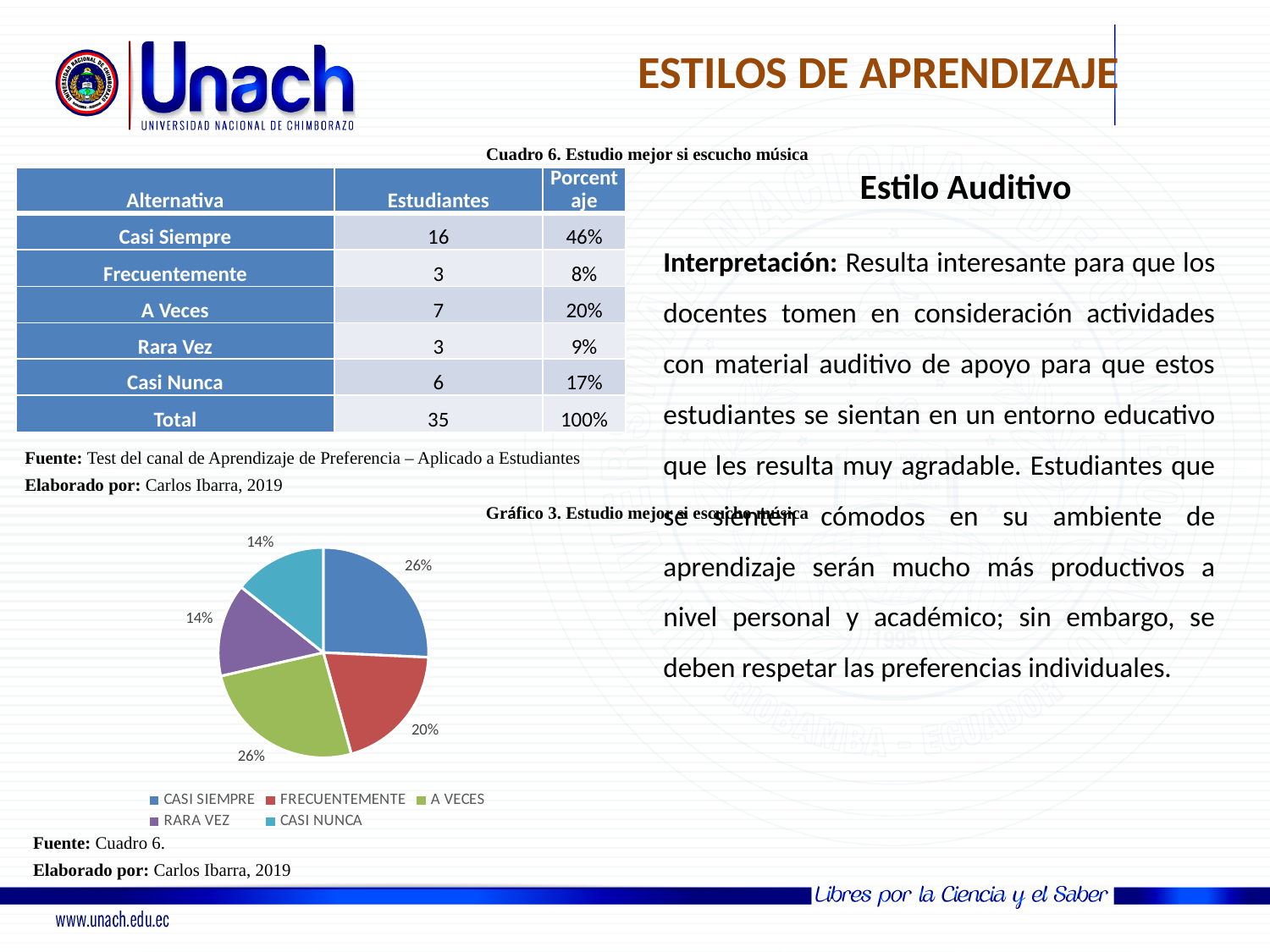
What kind of chart is shown on the slide? pie chart In the pie chart, what percentage is shown for RARA VEZ? 14% In the pie chart, what is the difference in percentage points between CASI SIEMPRE and RARA VEZ? 12 How many entries does the pie chart's legend list? 5 In the pie chart, what percentage is shown for CASI NUNCA? 14% In the pie chart, what percentage is shown for FRECUENTEMENTE? 20% What colour is the CASI SIEMPRE slice in the pie chart? blue In the pie chart, which is larger: CASI SIEMPRE or FRECUENTEMENTE? CASI SIEMPRE In the pie chart, what percentage is shown for A VECES? 26% How many slices does the pie chart have? 5 In the pie chart, what percentage is shown for CASI SIEMPRE? 26% In the pie chart, which is larger: A VECES or CASI NUNCA? A VECES